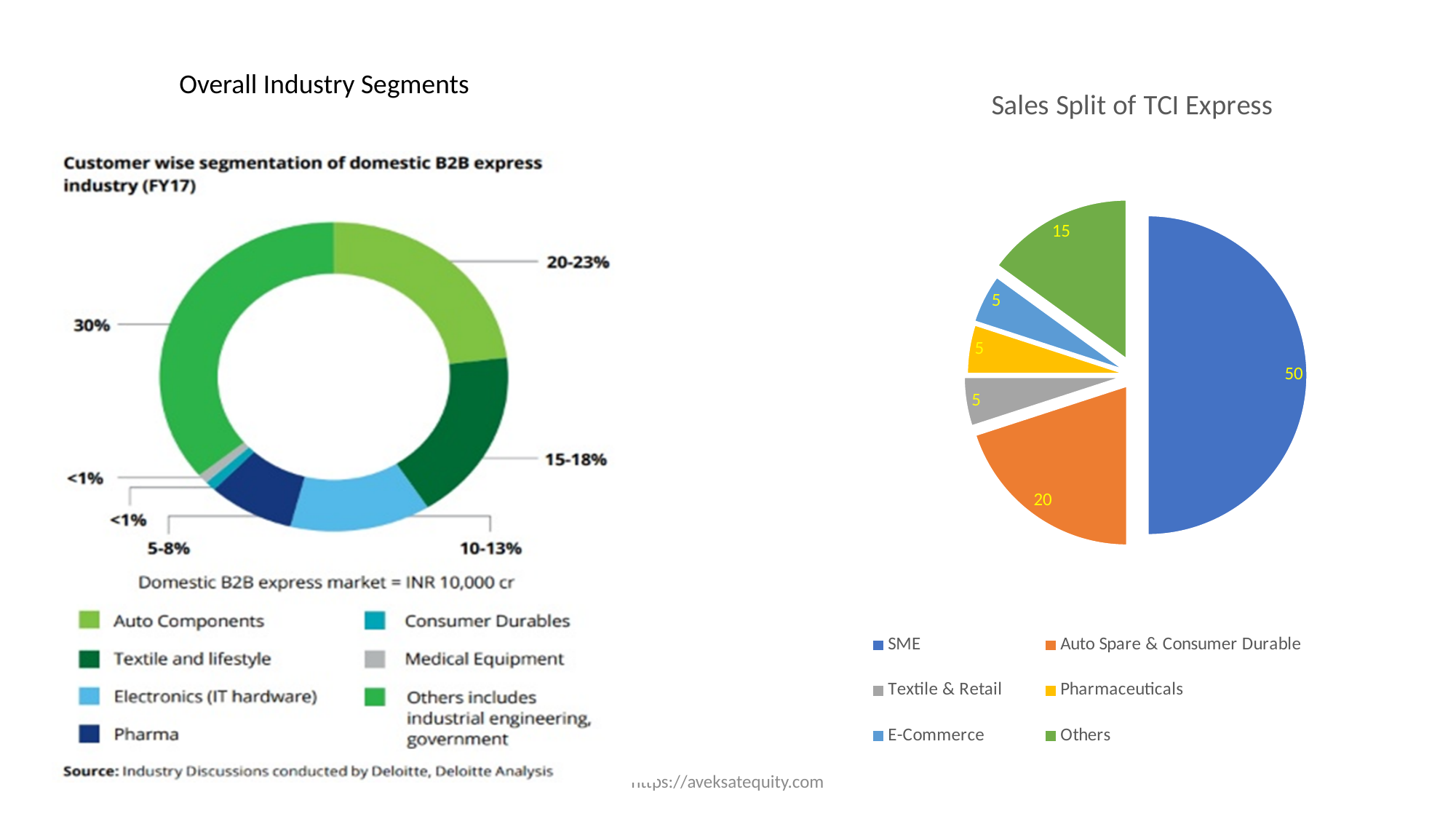
In the Customer wise segmentation of domestic B2B express industry (FY17) chart, what share is shown for the Others segment? 30% According to the left chart, what is the size of the domestic B2B express market? INR 10,000 cr In the Customer wise segmentation of domestic B2B express industry (FY17) chart, what share is shown for Auto Components? 20-23% What kind of chart is the Sales Split of TCI Express chart? Pie chart In the Sales Split of TCI Express chart, what is the value for Others? 15 In the Sales Split of TCI Express chart, which category has the largest slice? SME In the Sales Split of TCI Express chart, what is the value for Auto Spare & Consumer Durable? 20 In the Sales Split of TCI Express chart, which is larger, Others or E-Commerce? Others In the Sales Split of TCI Express chart, what is the value for SME? 50 How many categories does the legend of the Sales Split of TCI Express chart list? 6 In the Customer wise segmentation of domestic B2B express industry (FY17) chart, what share is shown for Electronics (IT hardware)? 10-13% In the Sales Split of TCI Express chart, what is the difference between the SME value and the Auto Spare & Consumer Durable value? 30